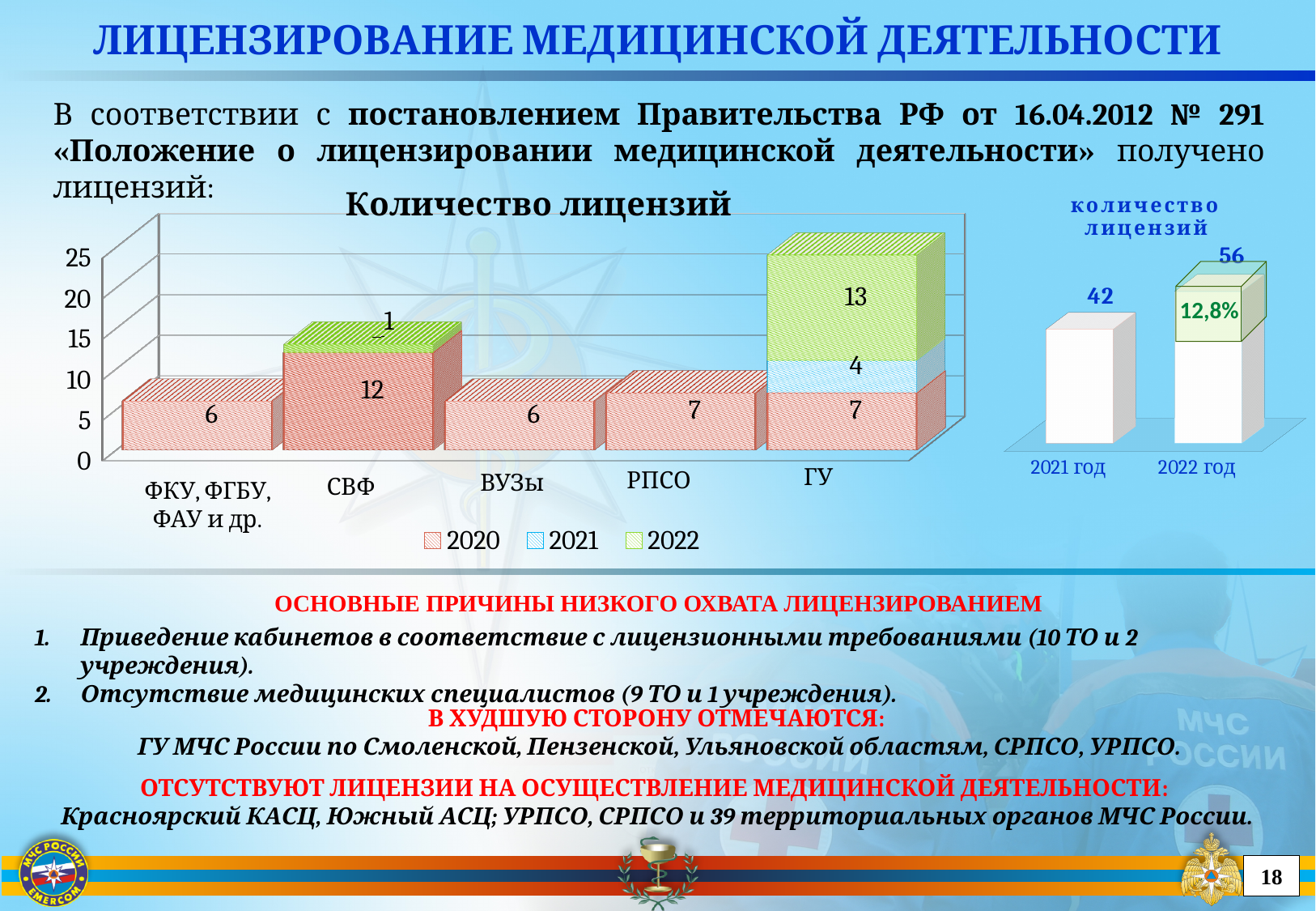
In the chart titled "Количество лицензий", what is the 2020 value for СВФ? 12 In the chart titled "Количество лицензий", what is the total of the stacked bar for СВФ? 13 In the chart titled "Количество лицензий", what is the 2022 value for ГУ? 13 In the chart titled "Количество лицензий", what is the 2020 value for РПСО? 7 In the chart titled "Количество лицензий", what is the 2021 value for ГУ? 4 In the small chart on the right titled "количество лицензий", what is the value for 2022 год? 56 In the chart titled "Количество лицензий", how many series does the legend list? 3 In the chart titled "Количество лицензий", which category has the highest 2020 value? СВФ In the chart titled "Количество лицензий", how many categories are shown on the x axis? 5 In the chart titled "Количество лицензий", what is the difference between the 2020 values for СВФ and ВУЗы? 6 In the small chart on the right titled "количество лицензий", what is the difference between the values for 2022 год and 2021 год? 14 In the chart titled "Количество лицензий", what is the total of the stacked bar for ГУ? 24